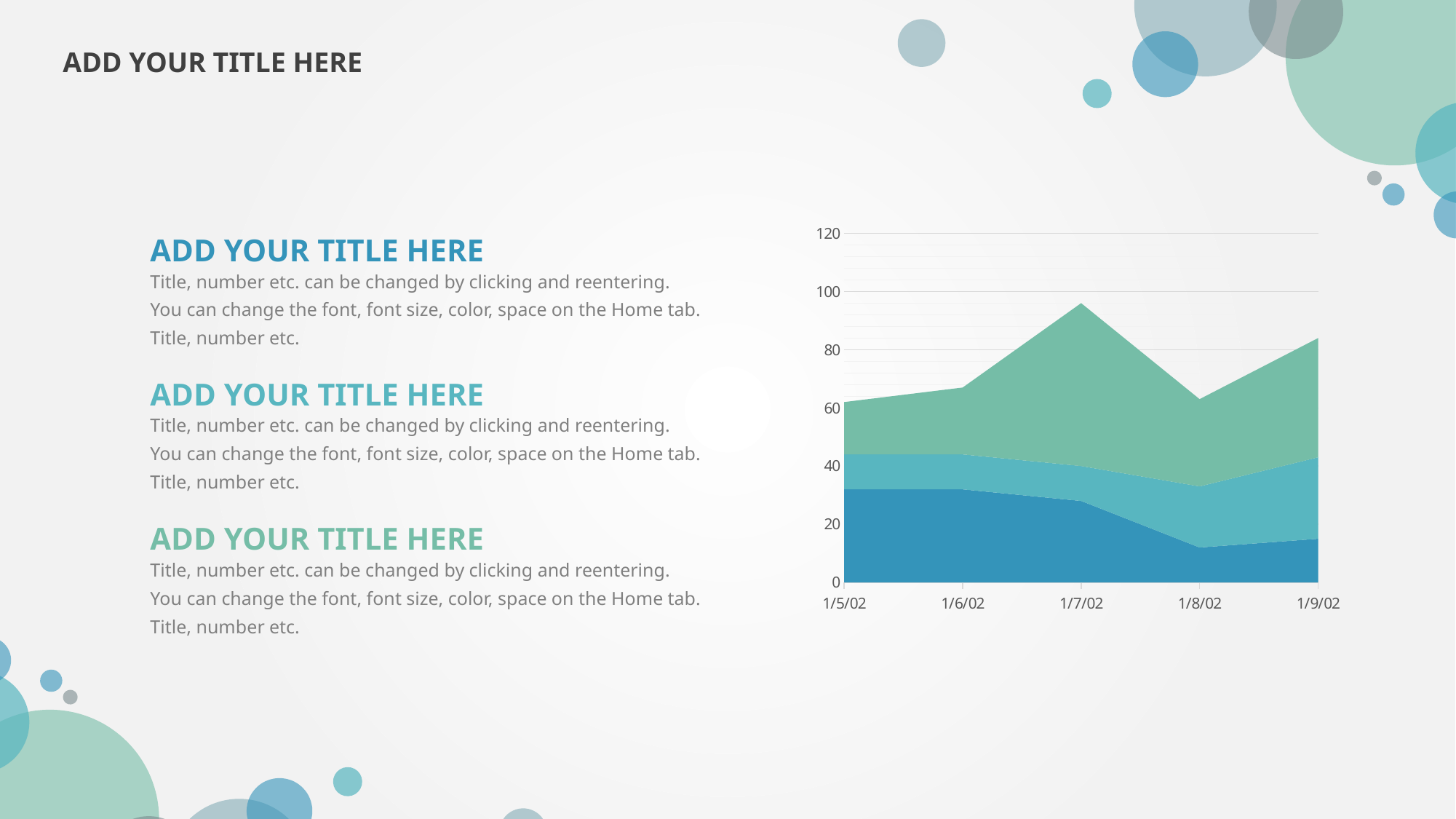
How many dates are shown on the x axis of the chart? 5 Does the bottom (dark blue) series rise or fall from 1/5/02 to 1/8/02? fall What is the highest tick value shown on the y axis of the chart? 120 Is the total stacked value at 1/7/02 greater or less than 80? greater Is the value of the bottom (dark blue) series at 1/8/02 greater or less than 20? less How many stacked series (coloured areas) are plotted in the chart? 3 Is the total stacked value at 1/9/02 greater or less than 80? greater On which date does the top of the stacked area reach its highest point? 1/7/02 Which is larger for the bottom (dark blue) series: the value at 1/5/02 or at 1/8/02? 1/5/02 What kind of chart is shown on the slide? area chart